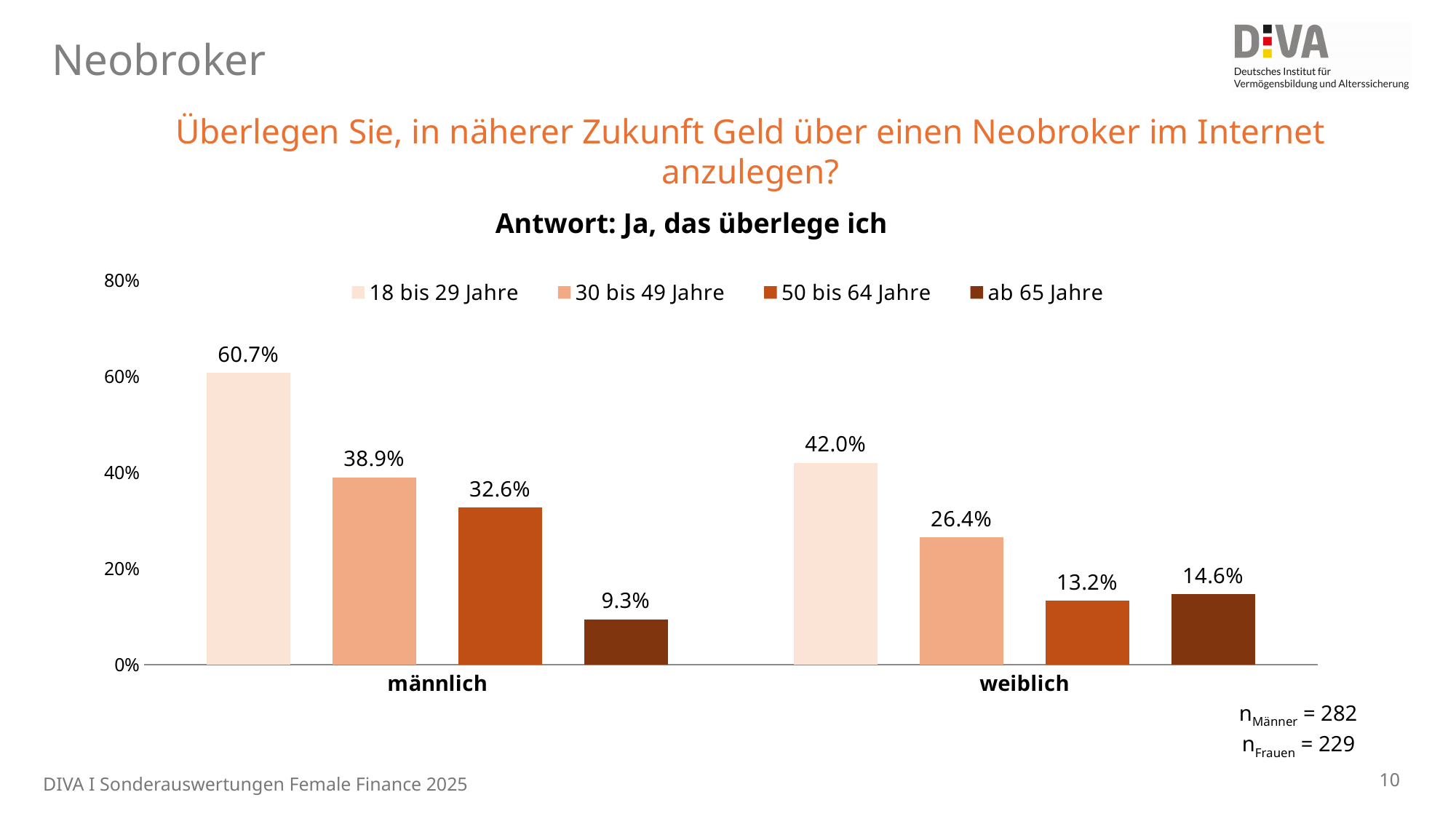
What kind of chart is shown on the slide? bar chart Which is larger: the 50 bis 64 Jahre value for männlich or the 30 bis 49 Jahre value for weiblich? 50 bis 64 Jahre for männlich What is the value for the 30 bis 49 Jahre series in the weiblich group? 26.4% What is the subtitle printed directly above the chart? Antwort: Ja, das überlege ich How many series does the legend list? 4 How many groups are shown on the x axis? 2 Is the value for ab 65 Jahre in the männlich group greater or less than 20%? less Which age group has the highest value in the männlich group? 18 bis 29 Jahre What is the difference between the 18 bis 29 Jahre values for männlich and weiblich? 18.7% What is the value for the ab 65 Jahre series in the weiblich group? 14.6% Which age group has the lowest value in the weiblich group? 50 bis 64 Jahre What is the value for the 18 bis 29 Jahre series in the männlich group? 60.7%